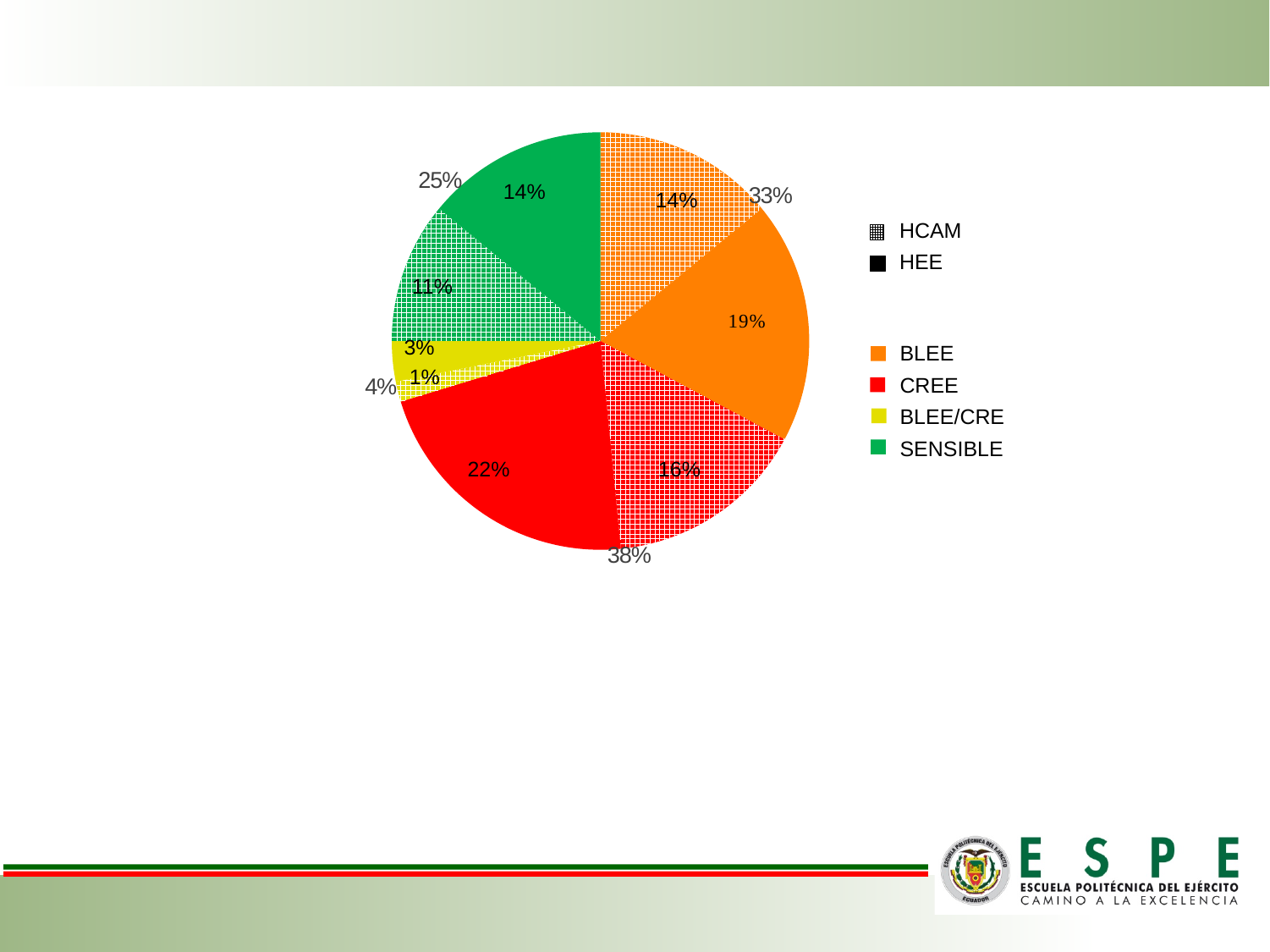
What kind of chart is shown on the slide? pie chart Which has a larger combined share, BLEE or SENSIBLE? BLEE What is the difference between the combined shares of CREE (38%) and SENSIBLE (25%)? 13% What is the percentage of the solid orange (BLEE, HEE) slice? 19% What is the percentage of the solid red (CREE, HEE) slice? 22% What is the combined percentage shown for the SENSIBLE category (outer label)? 25% Which category has the smallest combined share of the pie? BLEE/CRE What is the combined percentage shown for the CREE category (outer label)? 38% What is the combined percentage shown for the BLEE/CRE category (outer label)? 4% How many entries does the legend list? 6 Which category has the largest combined share of the pie? CREE What is the combined percentage shown for the BLEE category (outer label)? 33%